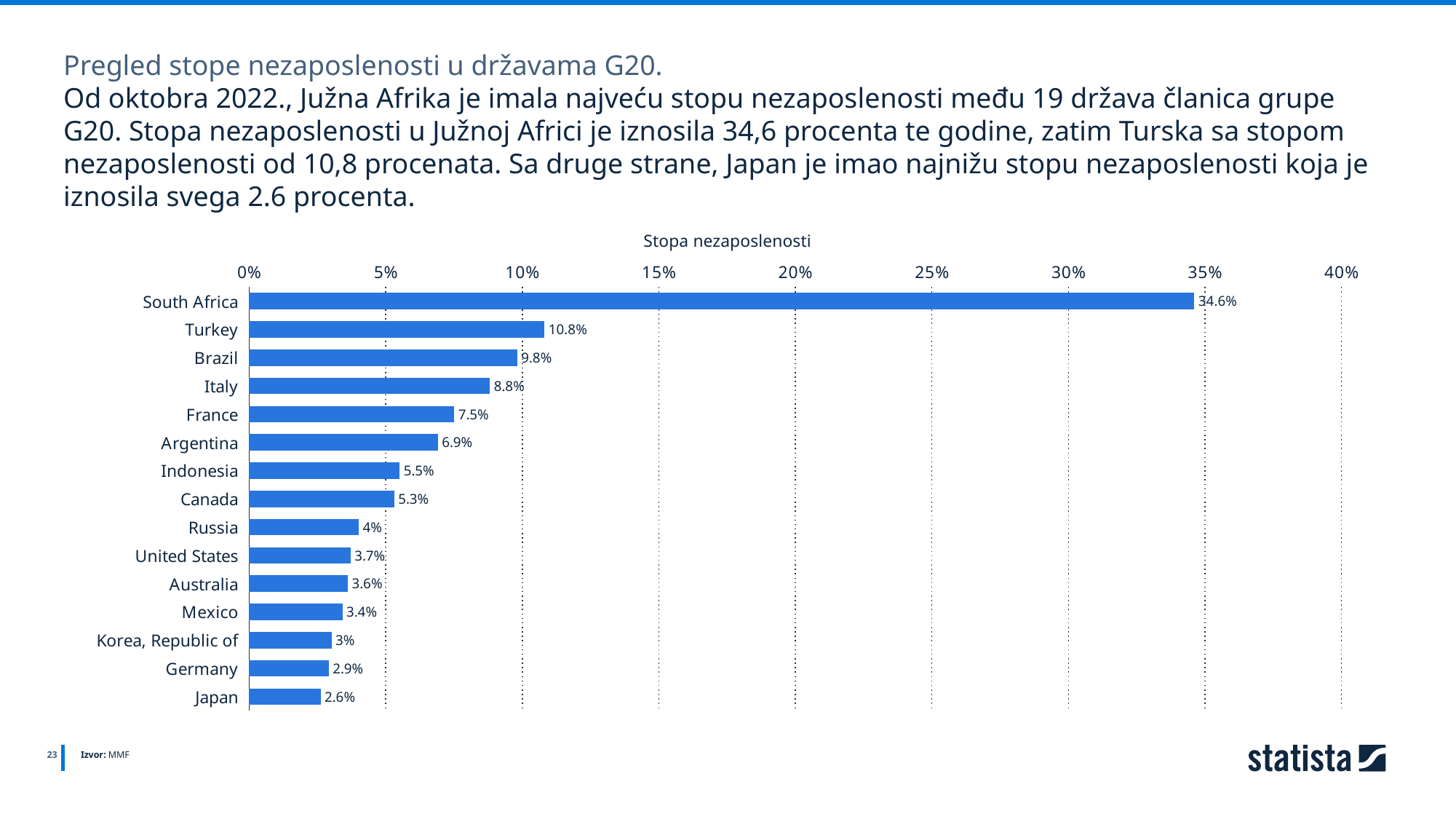
Is the value for Russia greater or less than 5%? less What is the unemployment rate shown for Turkey? 10.8% How many countries are shown in the chart? 15 What is the unemployment rate shown for Canada? 5.3% What is the title of the chart? Stopa nezaposlenosti Which has a higher unemployment rate, France or Argentina? France Which country has the highest unemployment rate in the chart? South Africa What is the unemployment rate shown for Germany? 2.9% What is the difference between the unemployment rates of Brazil and Italy? 1% Which country has the lowest unemployment rate in the chart? Japan What is the difference between the unemployment rates of South Africa and Turkey? 23.8% What kind of chart is shown on the slide? Bar chart